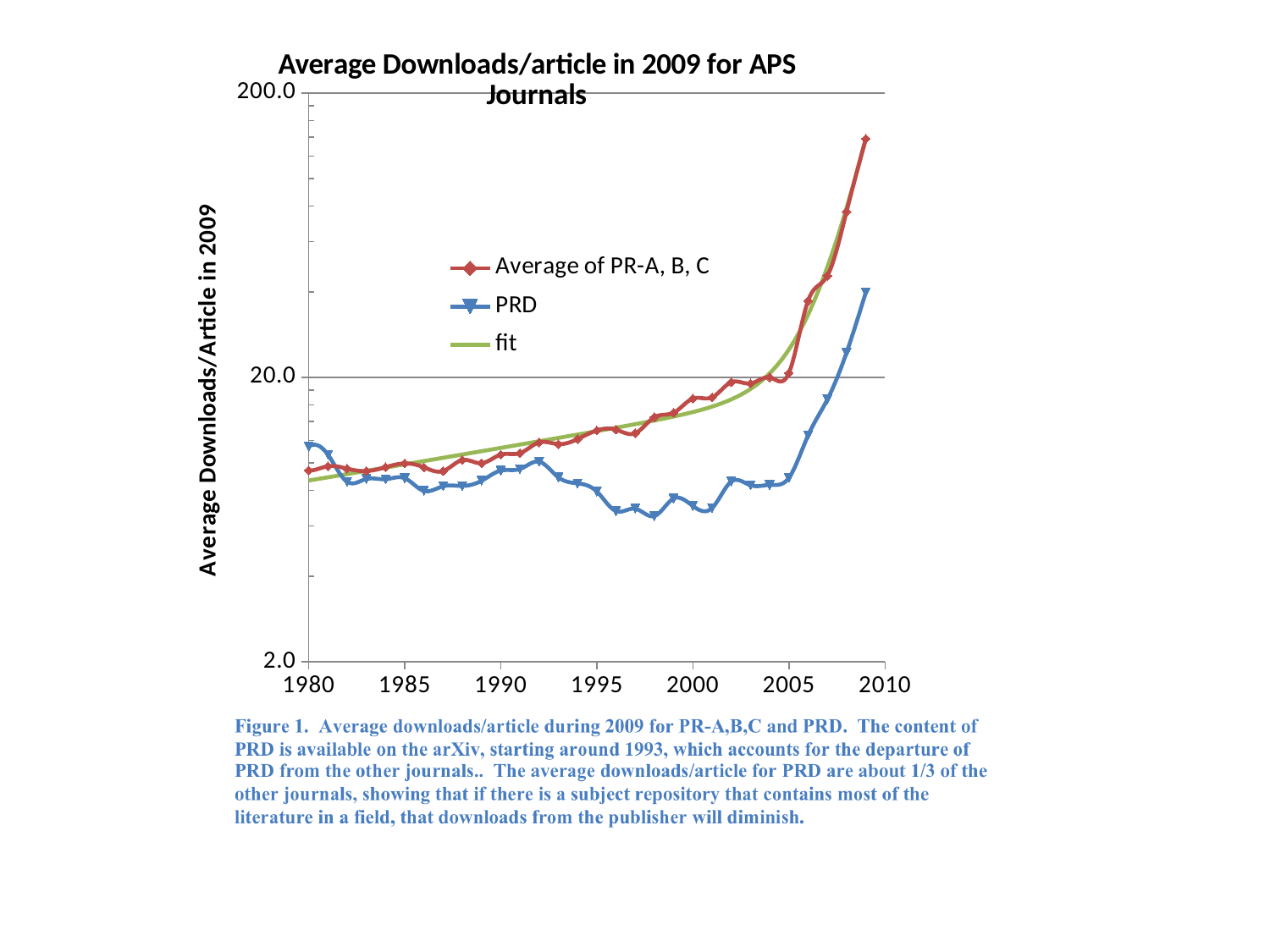
What kind of chart is shown on the slide? line chart Which series is drawn in green? fit Does the PRD series rise or fall between 2005 and 2009? rise In 1998, which series has the higher value, Average of PR-A, B, C or PRD? Average of PR-A, B, C What is the title of the chart? Average Downloads/article in 2009 for APS Journals Is the value for Average of PR-A, B, C in 2009 greater or less than 20.0? greater Is the value for PRD in 1998 greater or less than 20.0? less How many series does the legend list? 3 Does the PRD series rise or fall between 1992 and 1998? fall Is the value for Average of PR-A, B, C in 1980 greater or less than 20.0? less In 2009, which series has the higher value, Average of PR-A, B, C or PRD? Average of PR-A, B, C